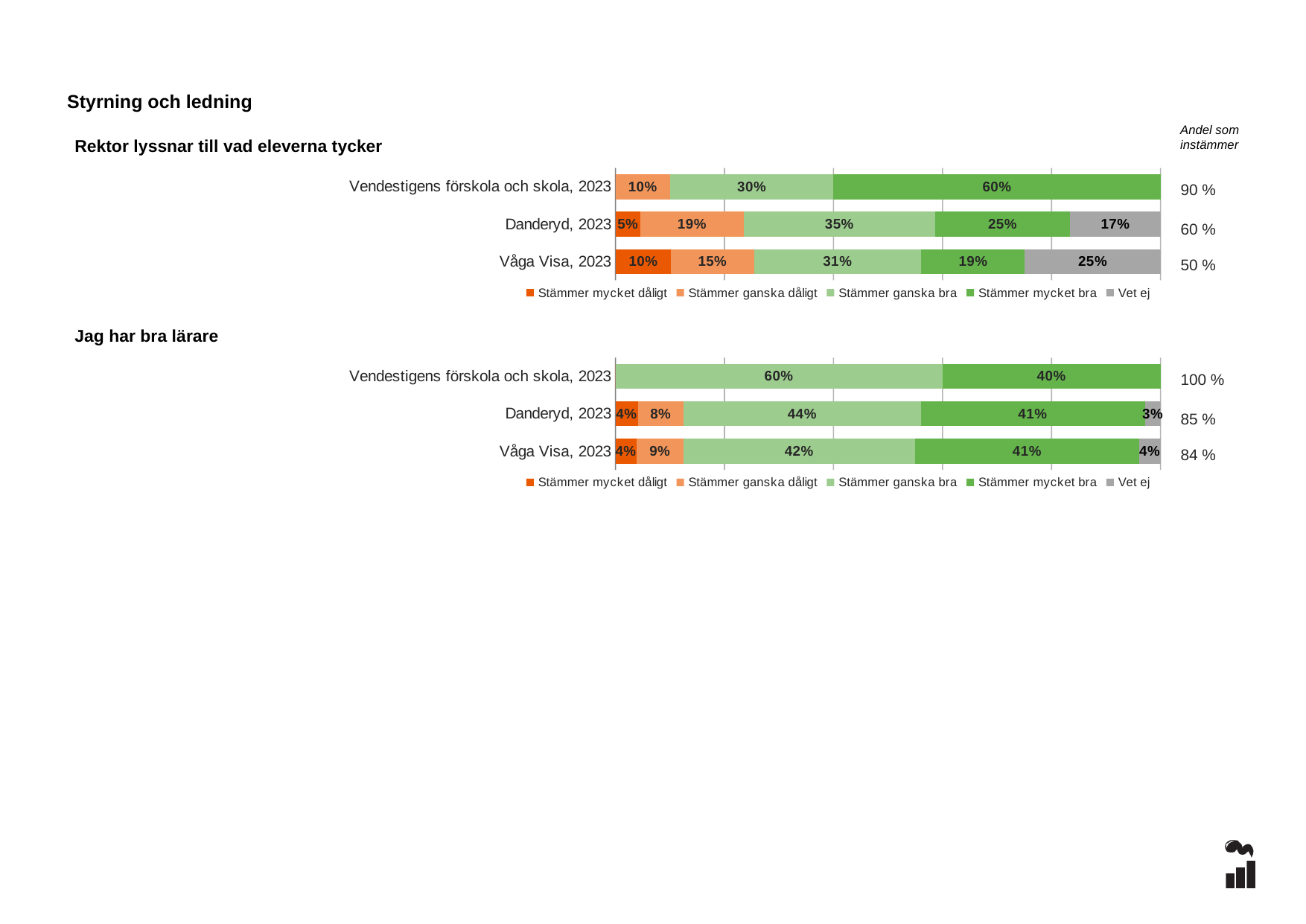
In the chart 'Rektor lyssnar till vad eleverna tycker', which category has the highest 'Stämmer mycket bra' value? Vendestigens förskola och skola, 2023 How many categories (bars) are shown in the chart 'Rektor lyssnar till vad eleverna tycker'? 3 In the chart 'Jag har bra lärare', which is larger: the 'Stämmer ganska bra' value for Danderyd, 2023 or for Våga Visa, 2023? Danderyd, 2023 In the chart 'Jag har bra lärare', what is the value of 'Stämmer ganska dåligt' for Våga Visa, 2023? 9% In the chart 'Jag har bra lärare', what is the value of 'Stämmer ganska bra' for Vendestigens förskola och skola, 2023? 60% In the chart 'Rektor lyssnar till vad eleverna tycker', what is the difference between the 'Stämmer ganska bra' values for Danderyd, 2023 and Våga Visa, 2023? 4% What kind of chart is 'Jag har bra lärare'? Stacked bar chart In the chart 'Jag har bra lärare', how many series does the legend list? 5 In the chart 'Jag har bra lärare', which category has the lowest 'Stämmer mycket bra' value? Vendestigens förskola och skola, 2023 In the chart 'Rektor lyssnar till vad eleverna tycker', what is the value of 'Stämmer mycket bra' for Vendestigens förskola och skola, 2023? 60% In the chart 'Rektor lyssnar till vad eleverna tycker', what is the value of 'Vet ej' for Våga Visa, 2023? 25% In the chart 'Rektor lyssnar till vad eleverna tycker', what is the 'Andel som instämmer' value shown for Danderyd, 2023? 60 %